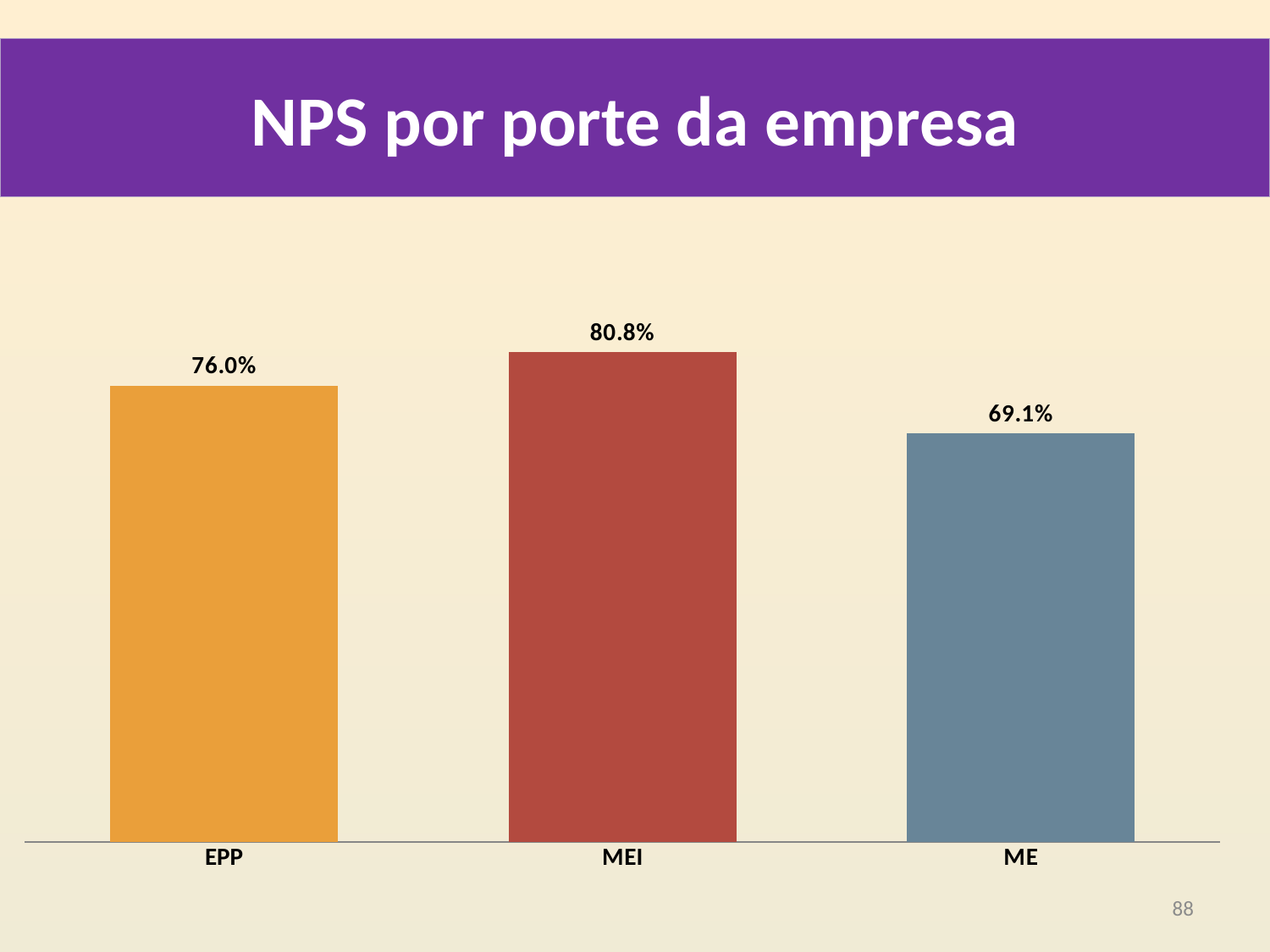
Which has a higher NPS, EPP or ME? EPP What is the difference between the NPS for MEI and the NPS for EPP? 4.8% Which company size category has the lowest NPS? ME Which company size category has the highest NPS? MEI What is the NPS value for MEI? 80.8% What colour is the bar for MEI? Red What is the NPS value for ME? 69.1% What is the difference between the NPS for MEI and the NPS for ME? 11.7% What is the title of the slide? NPS por porte da empresa How many company size categories are shown in the chart? 3 What is the NPS value for EPP? 76.0% What kind of chart is shown on the slide? Bar chart